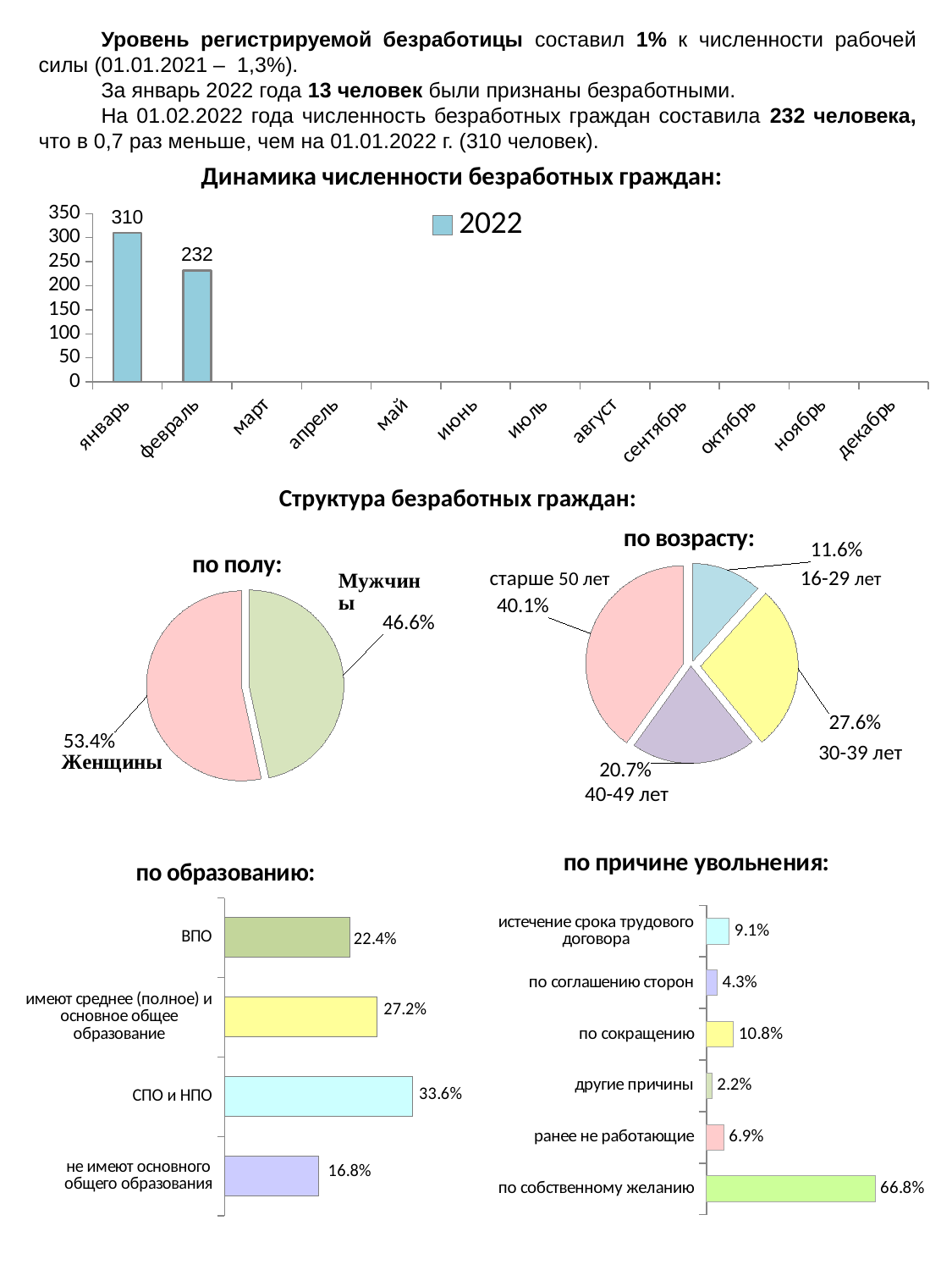
In the pie chart 'по возрасту', which age group has the smallest share? 16-29 лет What kind of chart is 'по причине увольнения'? bar chart In the chart 'по образованию', which is larger: ВПО or 'не имеют основного общего образования'? ВПО In the pie chart 'по полу', what share do Женщины have? 53.4% In the chart 'по причине увольнения', which reason has the highest value? по собственному желанию In the pie chart 'по возрасту', which age group has the largest share? старше 50 лет In the pie chart 'по возрасту', what is the share of the 30-39 лет group? 27.6% In the chart 'Динамика численности безработных граждан', how many month categories are shown on the x axis? 12 In the chart 'по образованию', what is the value for СПО и НПО? 33.6% In the chart 'Динамика численности безработных граждан', what is the difference between the values for январь and февраль? 78 In the chart 'Динамика численности безработных граждан', what is the value for январь? 310 In the chart 'Динамика численности безработных граждан', how many series does the legend list? 1